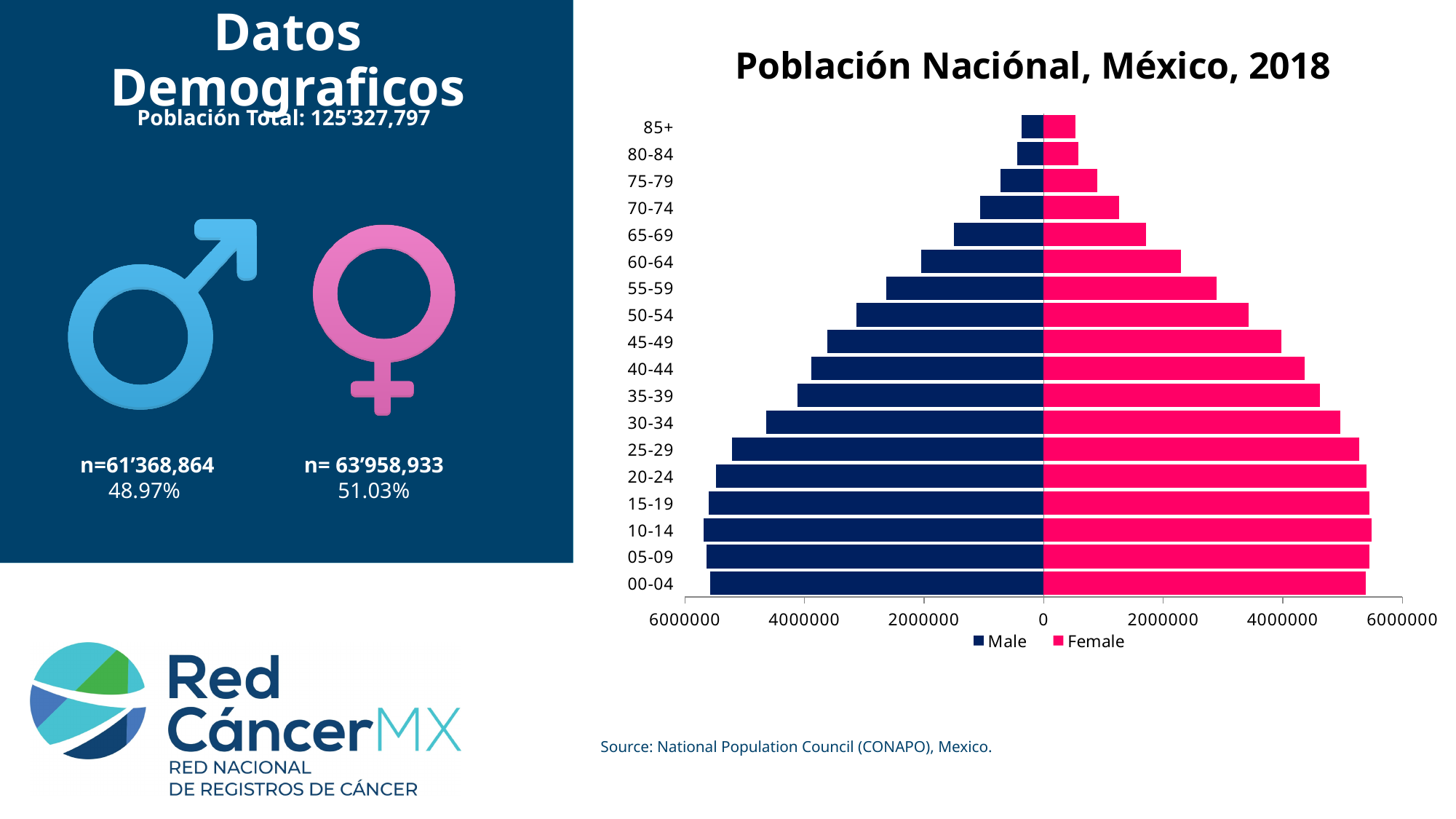
Which age group has the smallest Male population in the chart? 85+ Which colour represents the Female series in the population chart? pink Is the Female value for the 30-34 age group greater or less than 4000000? greater How many series does the legend of the population chart list? 2 What kind of chart is shown under the title 'Población Naciónal, México, 2018'? bar chart How many age groups are listed on the population chart? 18 Is the Male value for the 85+ age group greater or less than 2000000? less Do the population values generally rise or fall as the age groups get older in the chart? fall Which age group has the smallest Female population in the chart? 85+ Is the Male value for the 00-04 age group greater or less than 4000000? greater